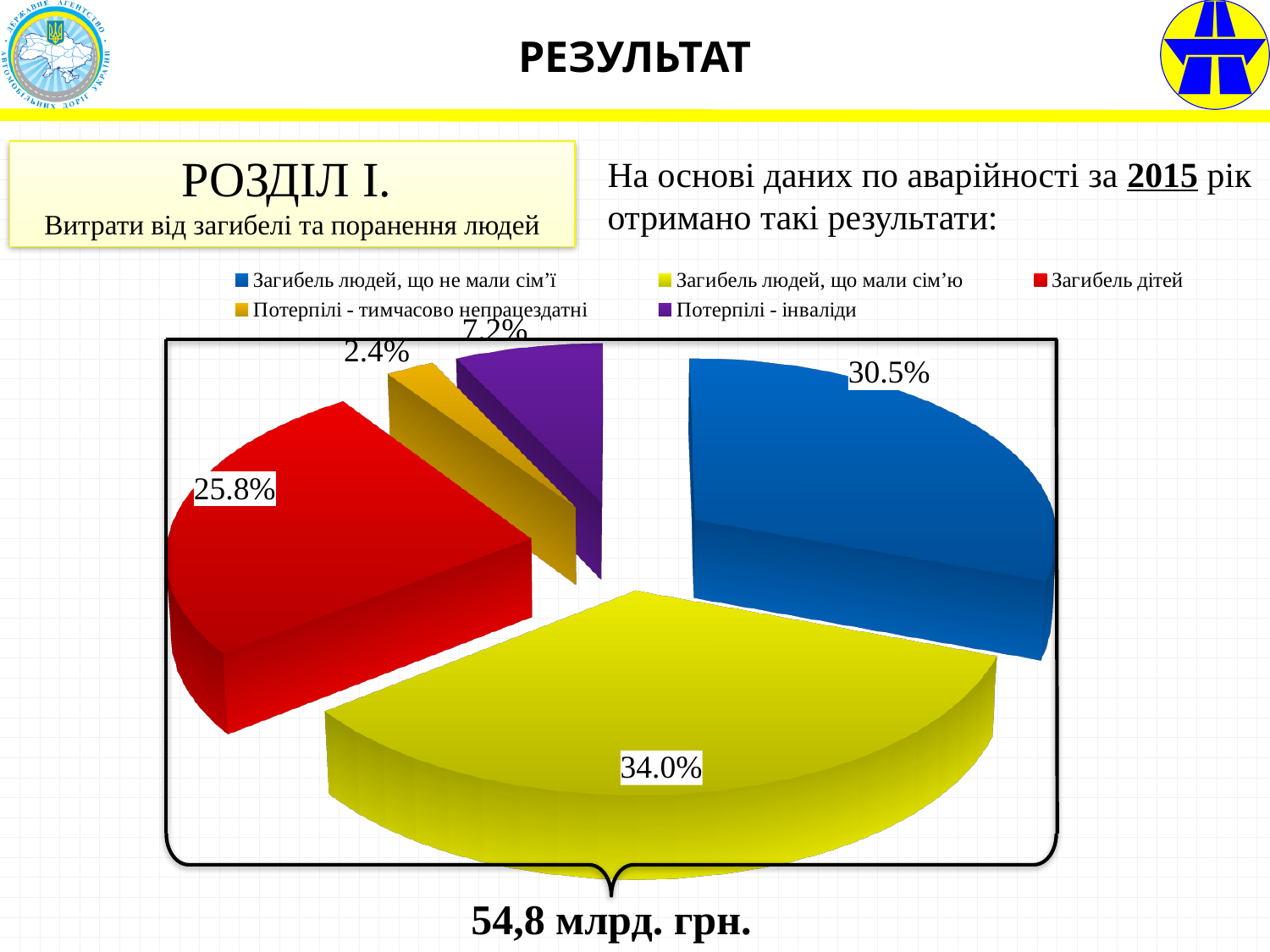
What kind of chart is shown on the slide? Pie chart What share of the pie is labelled for "Загибель людей, що мали сім'ю"? 34.0% What share of the pie is labelled for "Потерпілі - інваліди"? 7.2% What total amount is written below the pie chart? 54,8 млрд. грн. What is the difference in percentage points between the slices for "Загибель людей, що мали сім'ю" and "Загибель людей, що не мали сім'ї"? 3.5 Which category has the largest slice of the pie? Загибель людей, що мали сім'ю What share of the pie is labelled for "Загибель людей, що не мали сім'ї"? 30.5% Which slice is larger: "Загибель дітей" or "Потерпілі - інваліди"? Загибель дітей How many categories does the pie chart have? 5 What share of the pie is labelled for "Потерпілі - тимчасово непрацездатні"? 2.4% What share of the pie is labelled for "Загибель дітей"? 25.8% Which category has the smallest slice of the pie? Потерпілі - тимчасово непрацездатні